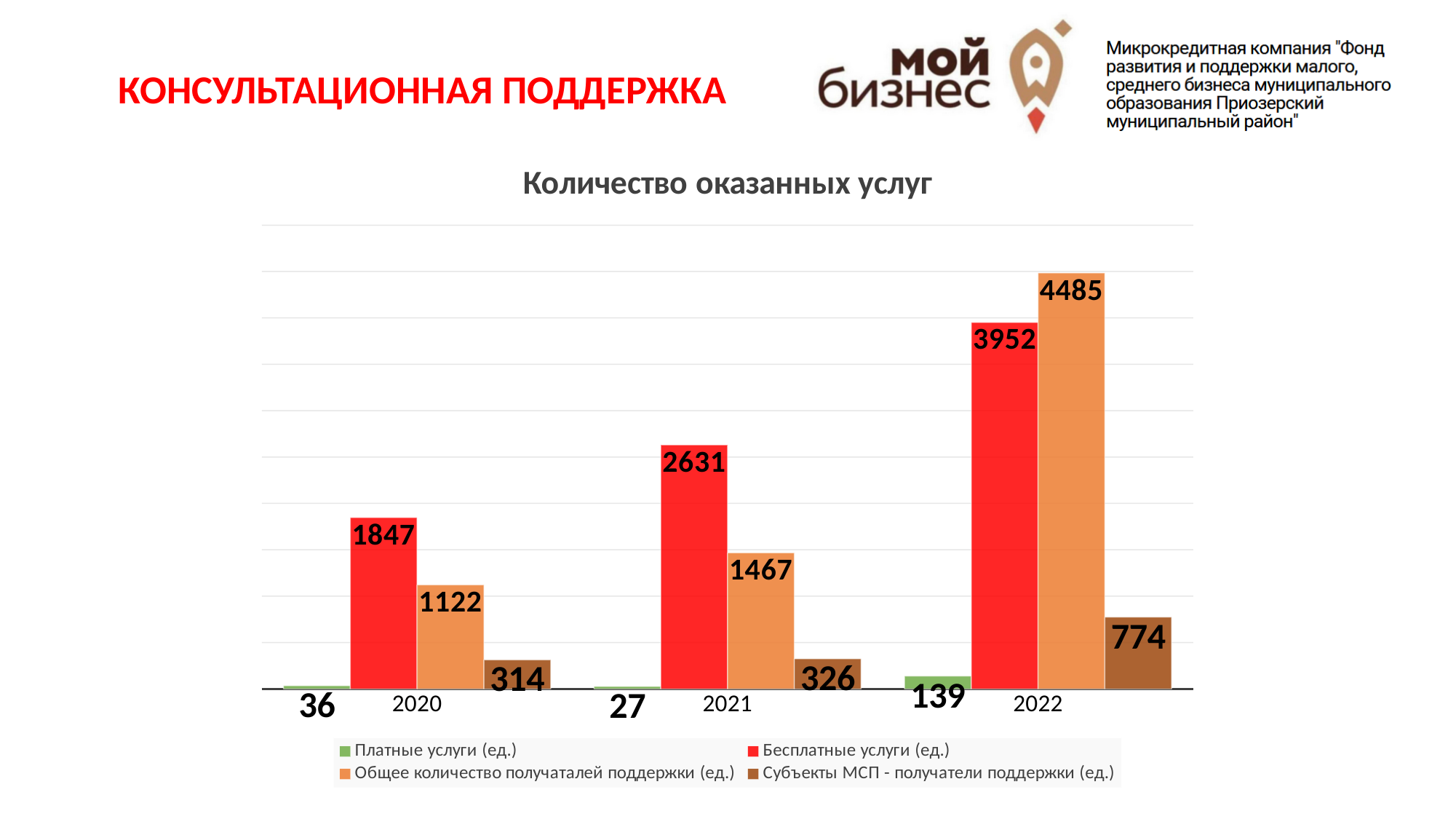
What kind of chart is shown? Bar chart What is the difference between Бесплатные услуги (ед.) in 2022 and in 2021? 1321 What is the value of Платные услуги (ед.) for 2020? 36 What is the value of Общее количество получаталей поддержки (ед.) for 2022? 4485 Which is larger: Общее количество получаталей поддержки (ед.) in 2020 or Бесплатные услуги (ед.) in 2020? Бесплатные услуги (ед.) in 2020 What is the value of Бесплатные услуги (ед.) for 2021? 2631 Does the value of Субъекты МСП - получатели поддержки (ед.) rise or fall from 2020 to 2022? Rise Which year has the lowest value for Платные услуги (ед.)? 2021 What is the value of Субъекты МСП - получатели поддержки (ед.) for 2021? 326 How many series does the legend list? 4 How many years are shown on the x axis? 3 Which year has the highest value for Бесплатные услуги (ед.)? 2022